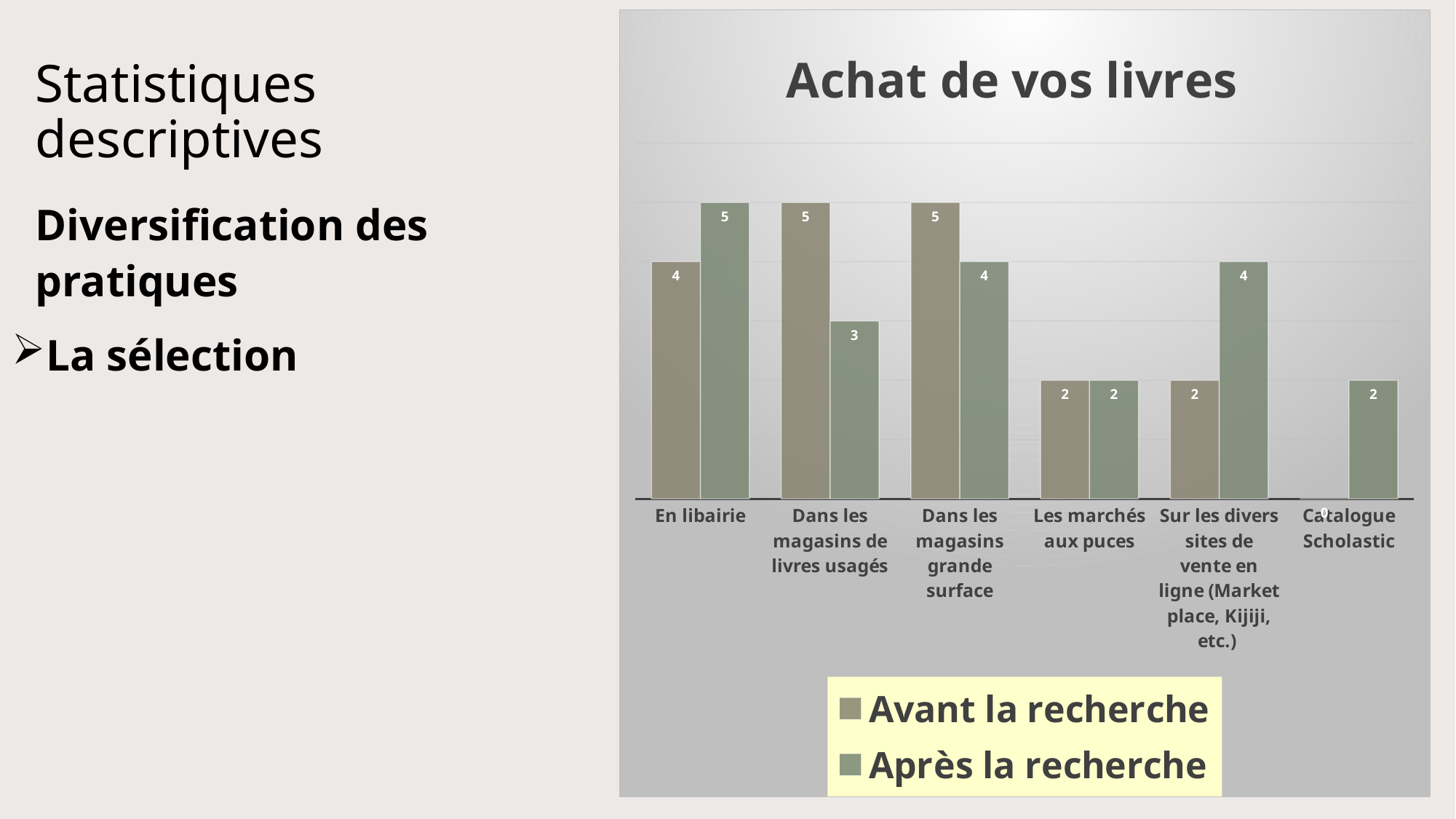
What is the value for 'Avant la recherche' for 'En libairie'? 4 What is the value for 'Après la recherche' for 'Catalogue Scholastic'? 2 For 'Sur les divers sites de vente en ligne (Market place, Kijiji, etc.)', which is larger: 'Avant la recherche' or 'Après la recherche'? Après la recherche What is the value for 'Après la recherche' for 'Dans les magasins de livres usagés'? 3 What is the value for 'Avant la recherche' for 'Sur les divers sites de vente en ligne (Market place, Kijiji, etc.)'? 2 What is the difference between the 'Avant la recherche' and 'Après la recherche' values for 'Dans les magasins de livres usagés'? 2 How many series does the legend list? 2 Which category has the lowest value for 'Avant la recherche'? Catalogue Scholastic Which legend entry is shown with the darker brownish-grey colour? Avant la recherche What type of chart is shown on the slide? bar chart How many categories are shown on the x axis of the chart? 6 What is the title of the chart? Achat de vos livres